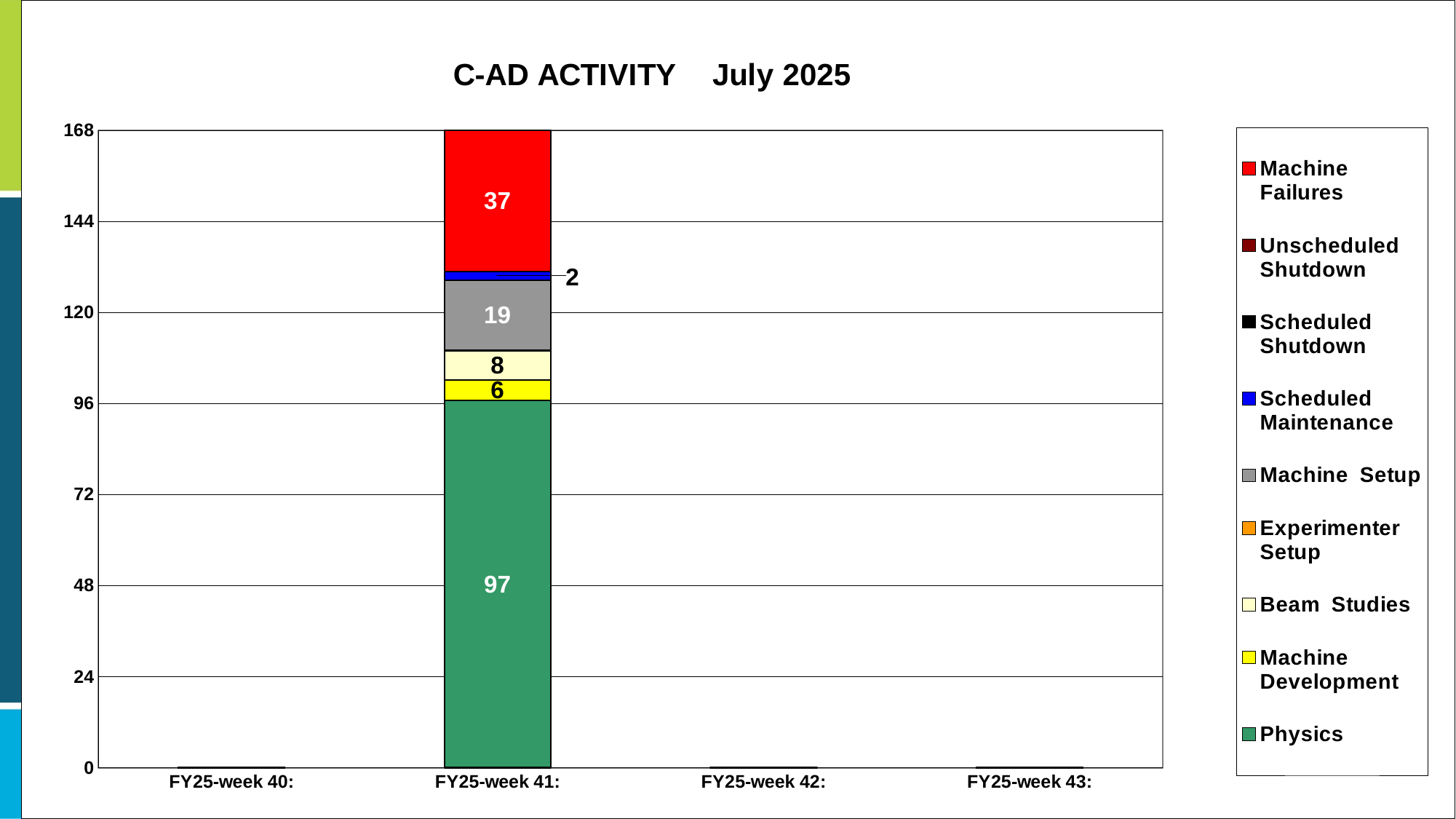
What is the value of the Machine Failures segment for FY25-week 41? 37 What kind of chart is shown on the slide? Stacked bar chart For FY25-week 41, which is larger: Beam Studies or Machine Development? Beam Studies What is the value of the Scheduled Maintenance segment for FY25-week 41? 2 Which labelled segment of the FY25-week 41 bar has the smallest value? Scheduled Maintenance What is the value of the Physics segment for FY25-week 41? 97 What is the value of the Beam Studies segment for FY25-week 41? 8 How many week categories are shown on the x axis? 4 What is the value of the Machine Setup segment for FY25-week 41? 19 How many series does the legend list? 9 Which segment of the FY25-week 41 bar has the largest value? Physics What is the difference between the Machine Failures and Machine Setup values for FY25-week 41? 18